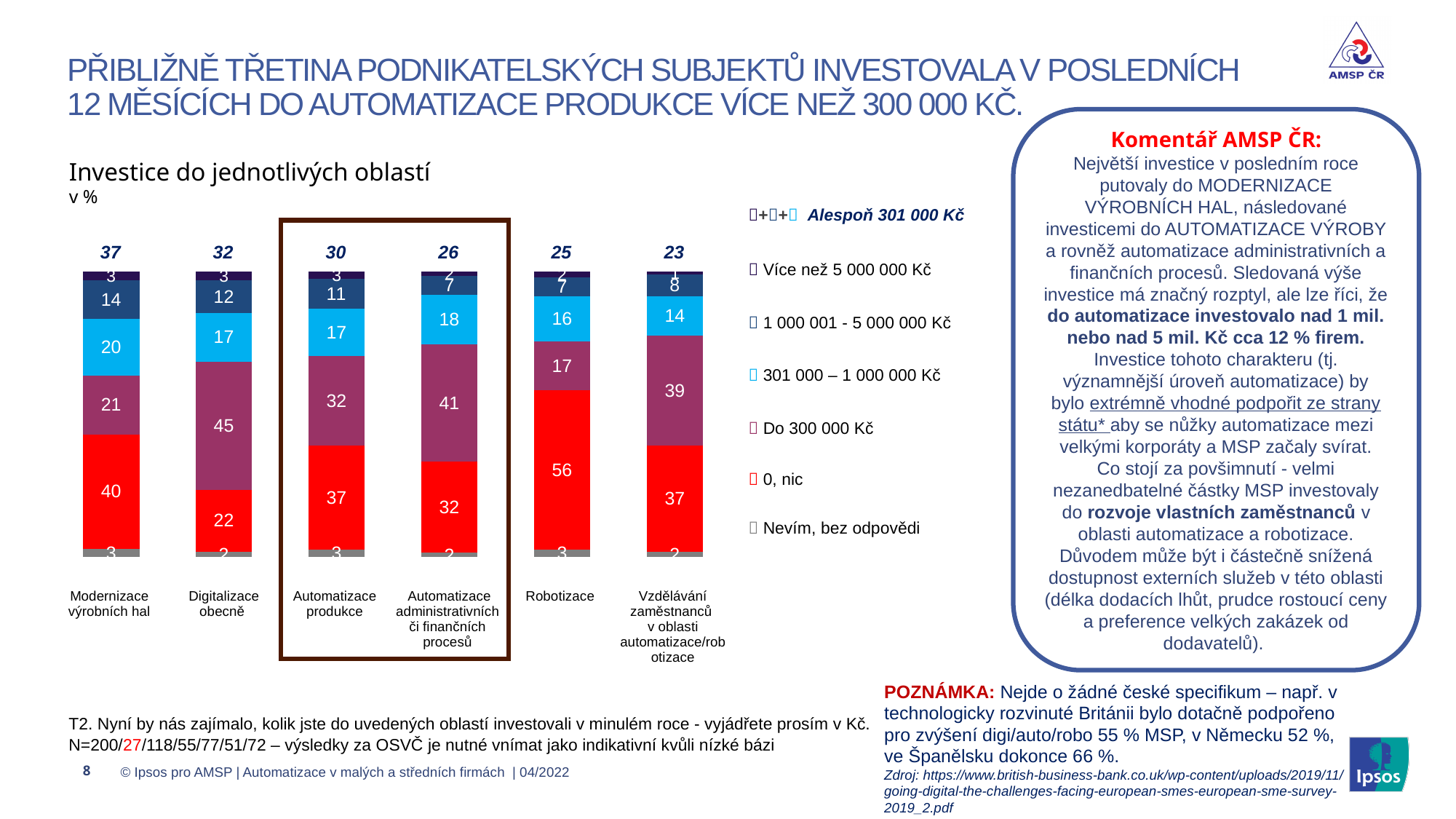
How many investment areas (categories) are shown on the x axis of the chart? 6 Which category has the lowest 'Alespoň 301 000 Kč' value shown above the bars? Vzdělávání zaměstnanců v oblasti automatizace/robotizace What is the 'Alespoň 301 000 Kč' total shown above the bar for Modernizace výrobních hal? 37 What is the value of the '0, nic' segment for Robotizace? 56 What is the difference between the '0, nic' values for Robotizace and Digitalizace obecně? 34 Which category has the highest 'Alespoň 301 000 Kč' value shown above the bars? Modernizace výrobních hal What is the value of the 'Více než 5 000 000 Kč' segment for Vzdělávání zaměstnanců v oblasti automatizace/robotizace? 1 What is the value of the 'Do 300 000 Kč' segment for Digitalizace obecně? 45 Which is larger: the '301 000 – 1 000 000 Kč' value for Modernizace výrobních hal or for Vzdělávání zaměstnanců v oblasti automatizace/robotizace? Modernizace výrobních hal What is the value of the '1 000 001 - 5 000 000 Kč' segment for Automatizace produkce? 11 What is the unit stated under the chart title 'Investice do jednotlivých oblastí'? v % What type of chart is shown on the slide? stacked bar chart